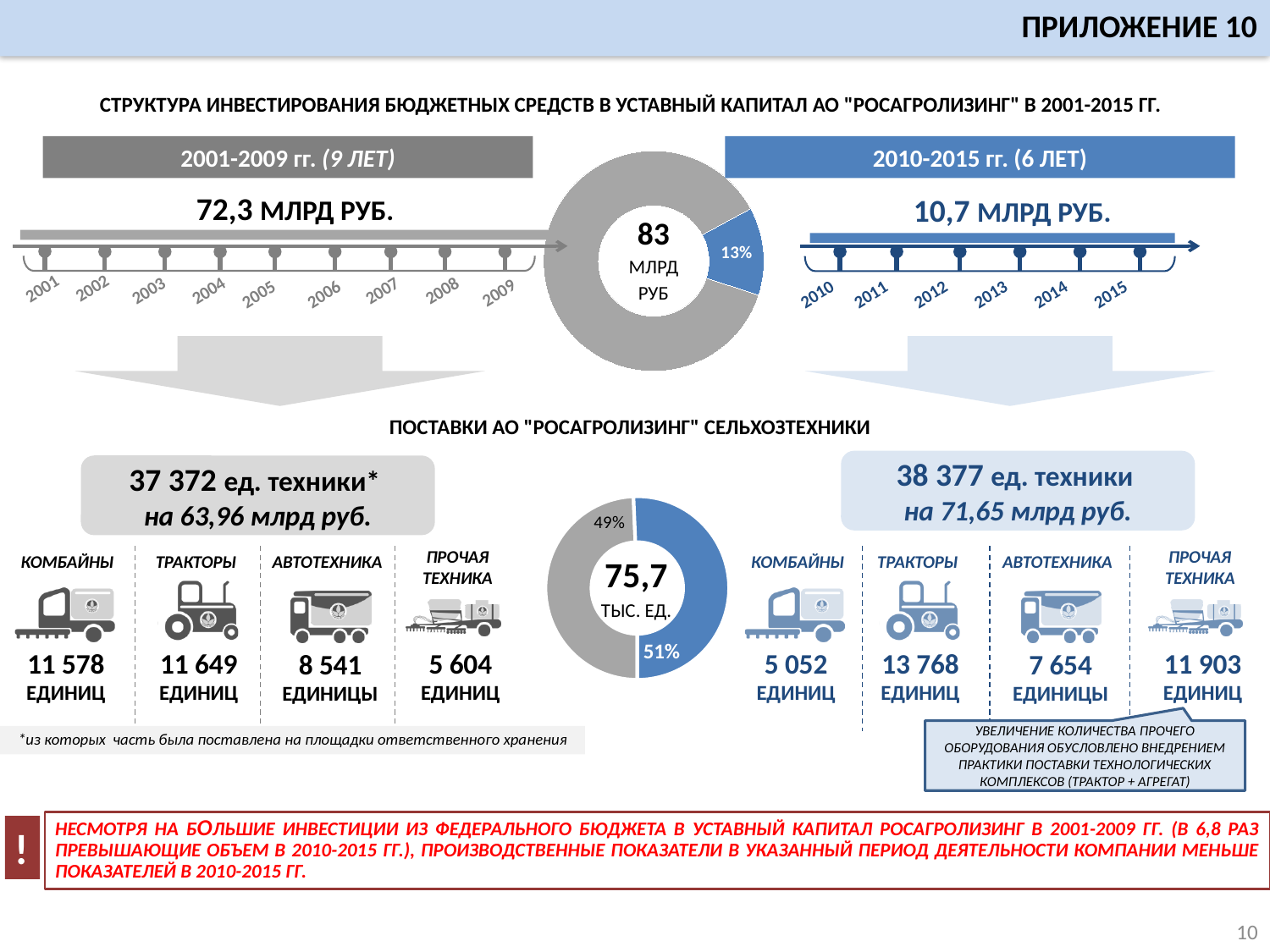
In the upper donut chart, what share is labelled on the blue slice? 13% How many slices does the upper donut chart (83 млрд руб) have? 2 In the lower donut chart, what is the difference between the blue slice share and the grey slice share? 2% What type of chart is the upper chart showing 83 млрд руб in the centre? Donut (pie) chart In the upper donut chart, is the blue slice greater or less than 50%? less In the lower donut chart, which slice is larger, the blue (51%) or the grey (49%)? Blue (51%) According to the slide, how much was invested in 2001-2009 (left block) versus 2010-2015 (right block)? 72,3 млрд руб. and 10,7 млрд руб. Which period has the larger number of tractors delivered: 2001-2009 (11 649) or 2010-2015 (13 768)? 2010-2015 What value is printed in the centre of the lower donut chart? 75,7 тыс. ед. In the lower donut chart (75,7 тыс. ед.), what share is labelled on the grey slice? 49% In the lower donut chart (75,7 тыс. ед.), what share is labelled on the blue slice? 51% What total value is printed in the centre of the upper donut chart? 83 млрд руб